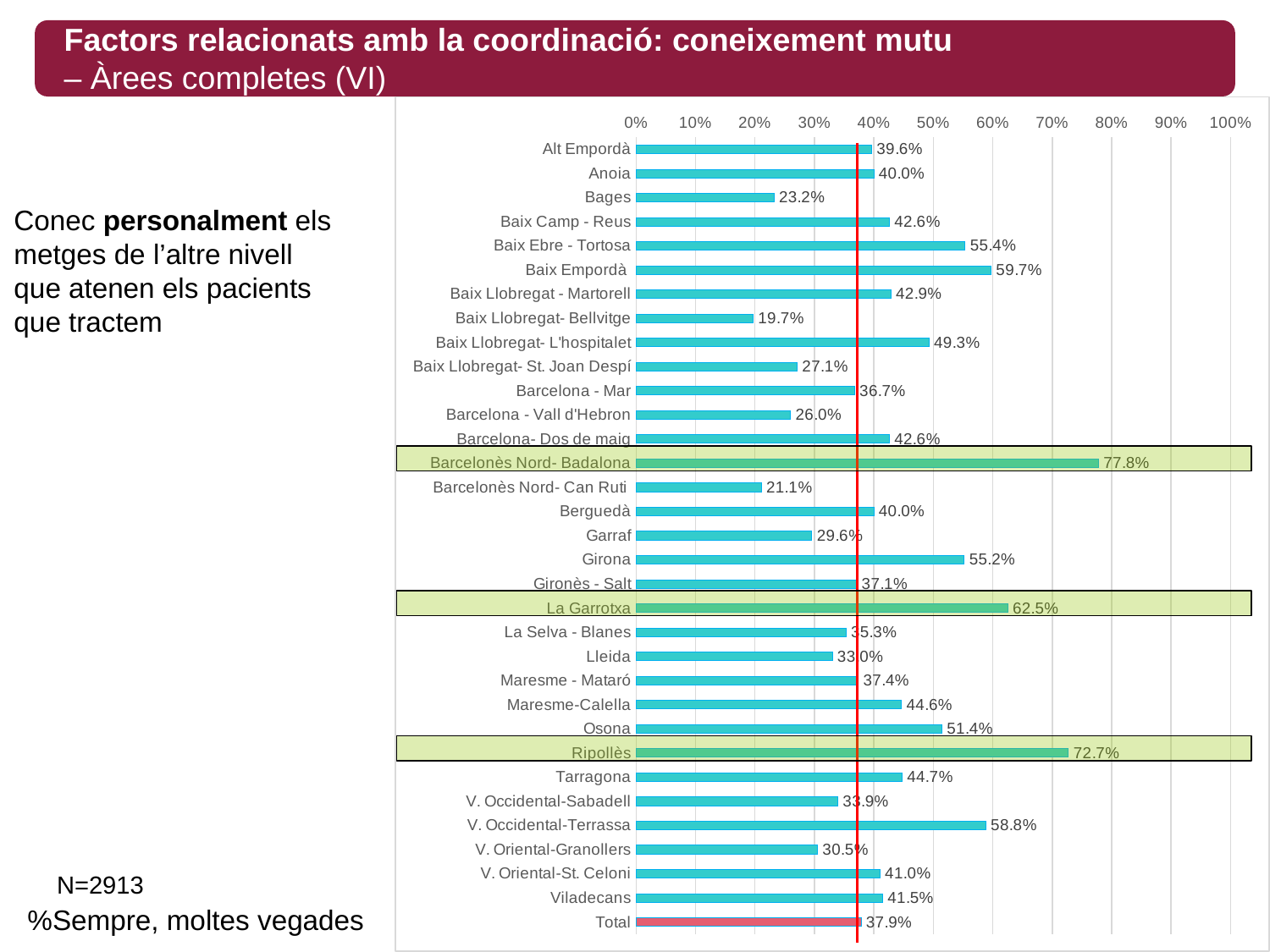
What is the value for Total? 37.9% What is the difference between the values for Barcelonès Nord- Badalona and Baix Llobregat- Bellvitge? 58.1 percentage points What is the value for Baix Llobregat- L'hospitalet? 49.3% Is the value for Ripollès greater or less than 70%? greater What is the value for Barcelonès Nord- Badalona? 77.8% What is the value for La Garrotxa? 62.5% What kind of chart is shown on the slide? Bar chart Which category has the lowest value? Baix Llobregat- Bellvitge Which category has the highest value? Barcelonès Nord- Badalona What is the difference between the values for Baix Empordà and Bages? 36.5 percentage points How many bars are plotted in the chart, including Total? 33 Which has a larger value, Osona or Tarragona? Osona